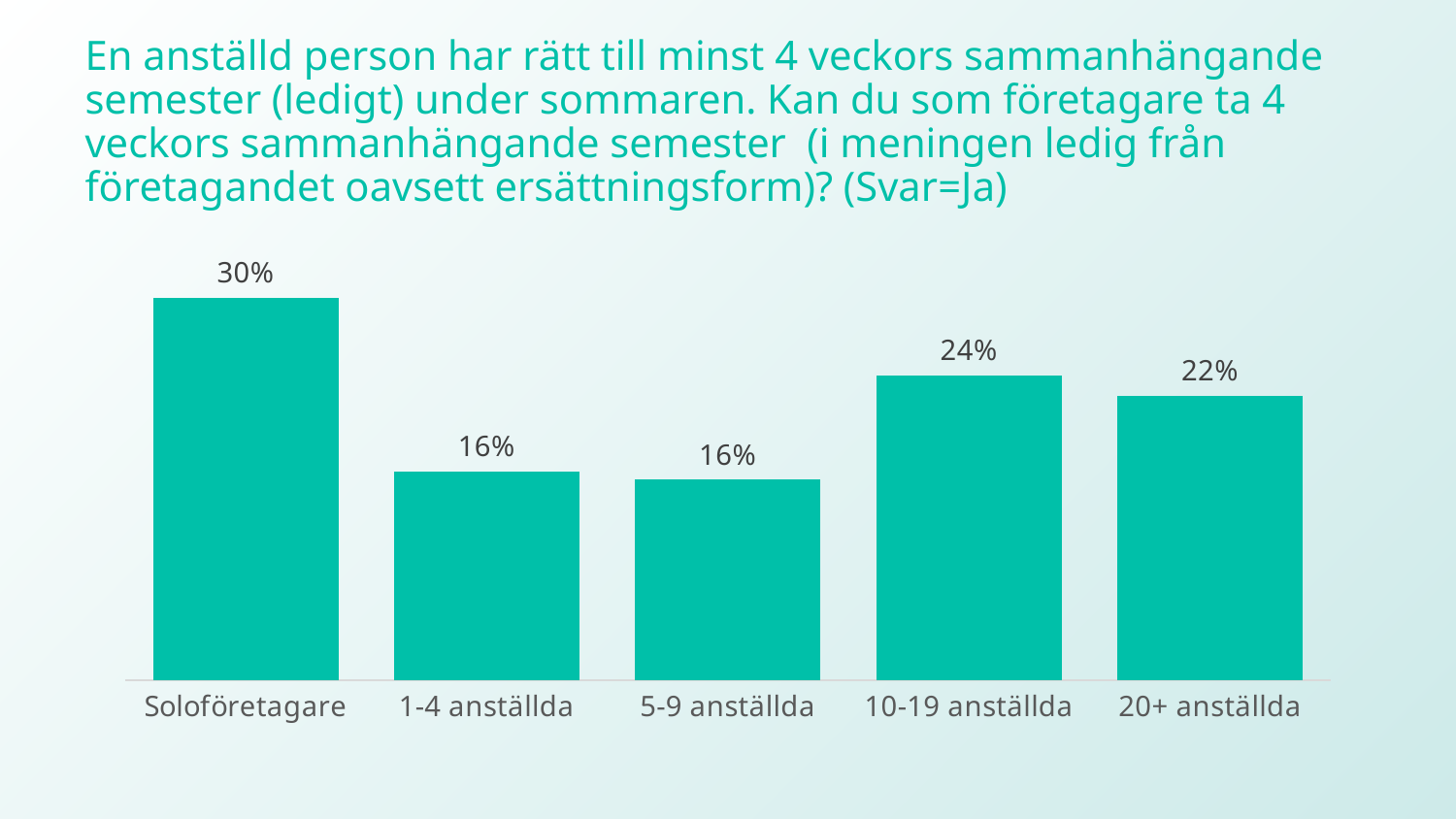
Which is larger, the value for 10-19 anställda or the value for 20+ anställda? 10-19 anställda What is the difference between the values for 10-19 anställda and 5-9 anställda? 8% Which category has the highest value? Soloföretagare What is the difference between the values for Soloföretagare and 20+ anställda? 8% What is the value for Soloföretagare? 30% What kind of chart is shown on the slide? bar chart How many categories are shown on the x axis? 5 What colour are the bars in the chart? teal What is the value for 1-4 anställda? 16% What is the value for 20+ anställda? 22% What is the value for 10-19 anställda? 24% Which two categories share the same value? 1-4 anställda and 5-9 anställda